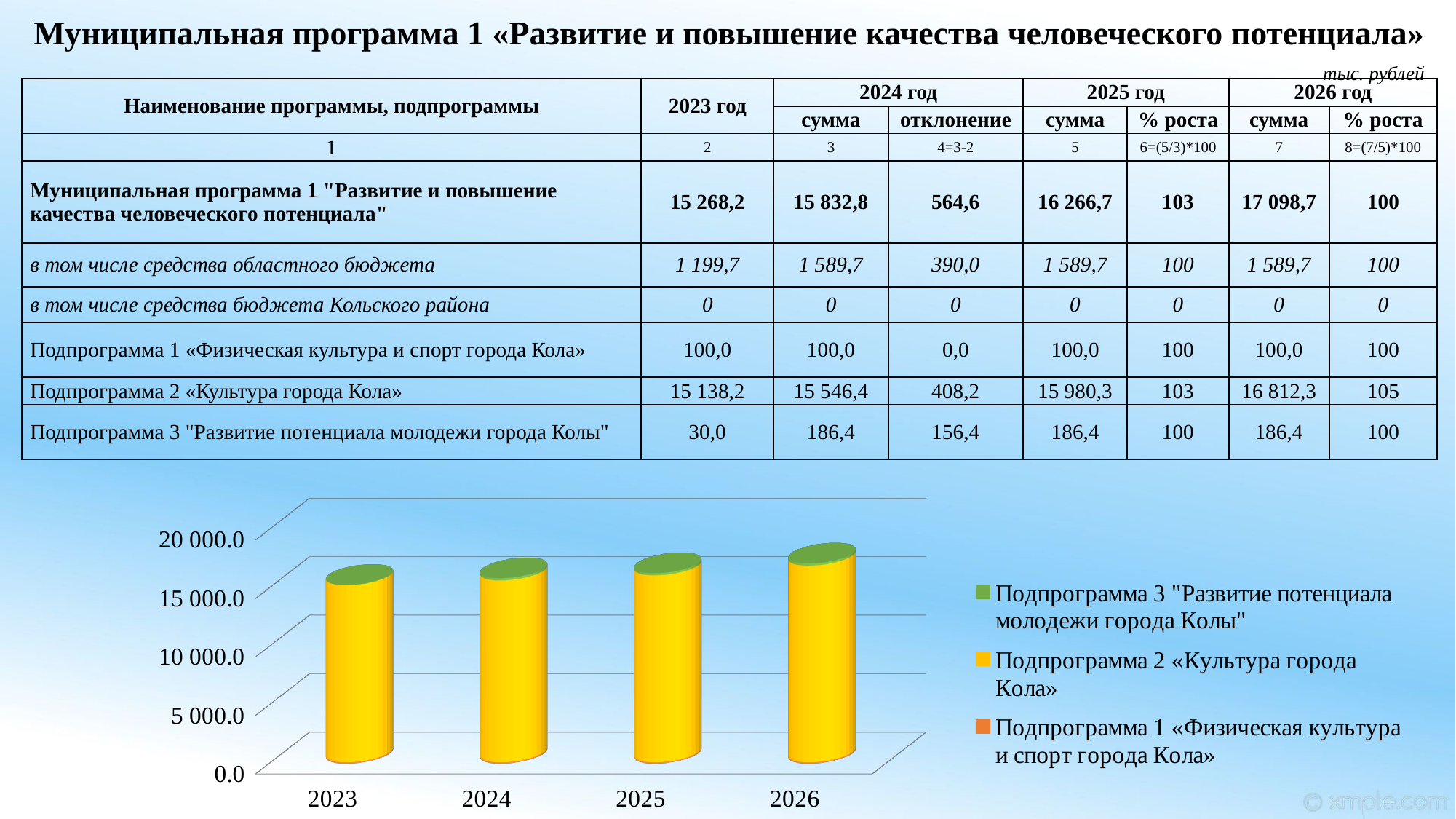
Which colour represents Подпрограмма 2 «Культура города Кола» in the chart legend? yellow Do the bar heights rise or fall from 2023 to 2026? rise Which year has the tallest bar in the chart? 2026 Which series makes up almost all of each bar in the chart? Подпрограмма 2 «Культура города Кола» What kind of chart is shown at the bottom of the slide? bar chart Is the total height of the bar for 2023 greater or less than 20 000.0? less Is the bar for 2026 taller or shorter than the bar for 2023? taller Is the total height of the bar for 2026 greater or less than 10 000.0? greater How many series does the chart legend list? 3 What is the highest value shown on the chart's vertical axis? 20 000.0 How many years are shown on the x axis of the chart? 4